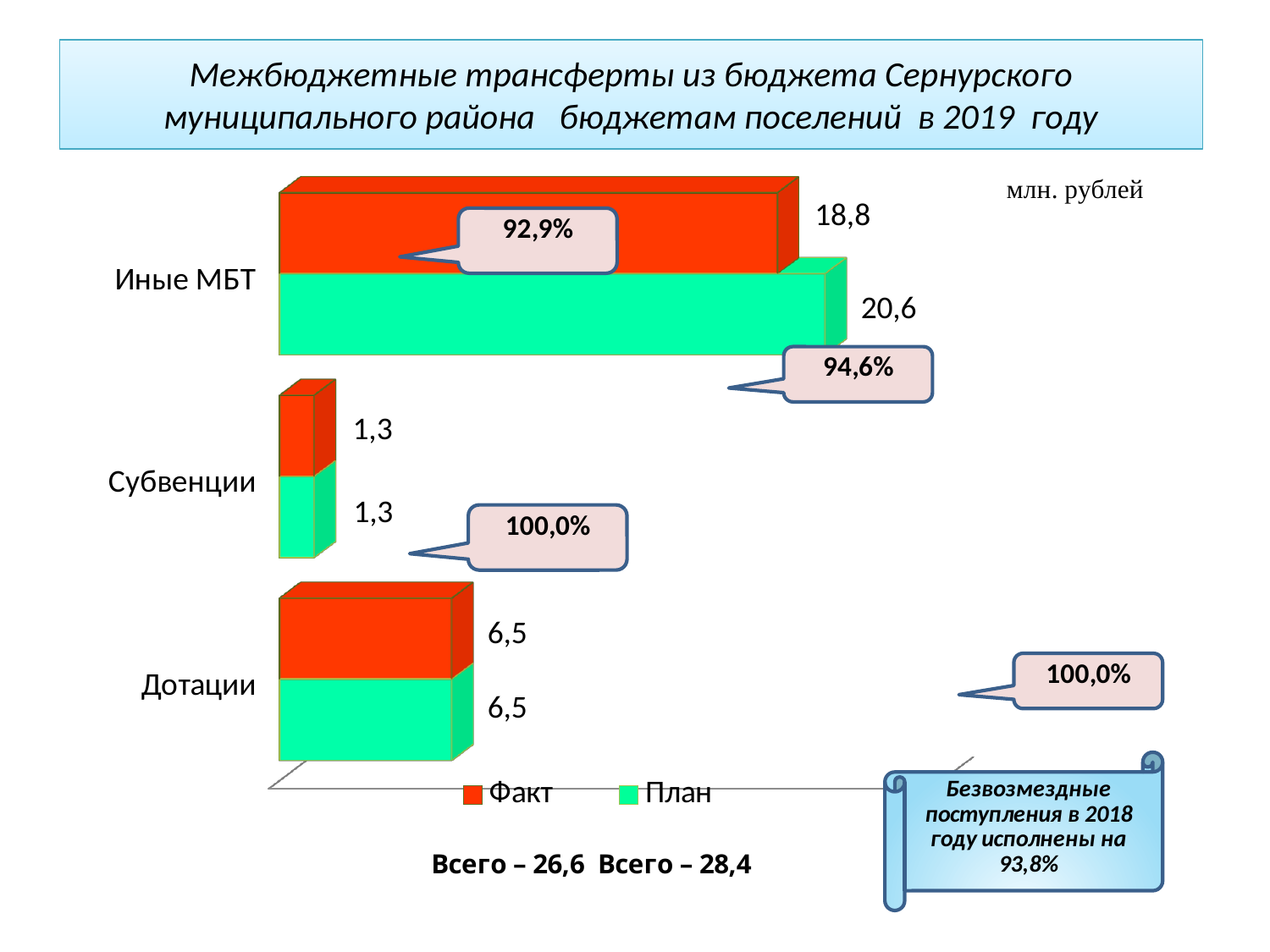
Which category has the lowest Факт value? Субвенции What is the Факт value for Иные МБТ? 18,8 What is the План value for Иные МБТ? 20,6 What kind of chart is shown on the slide? bar chart What is the Факт value for Дотации? 6,5 Which category has the highest План value? Иные МБТ Which colour represents the Факт series in the legend? red What is the difference between the План and Факт values for Иные МБТ? 1,8 Which is larger for Иные МБТ, the Факт value or the План value? План How many series does the legend list? 2 What is the План value for Субвенции? 1,3 How many categories are shown on the chart? 3